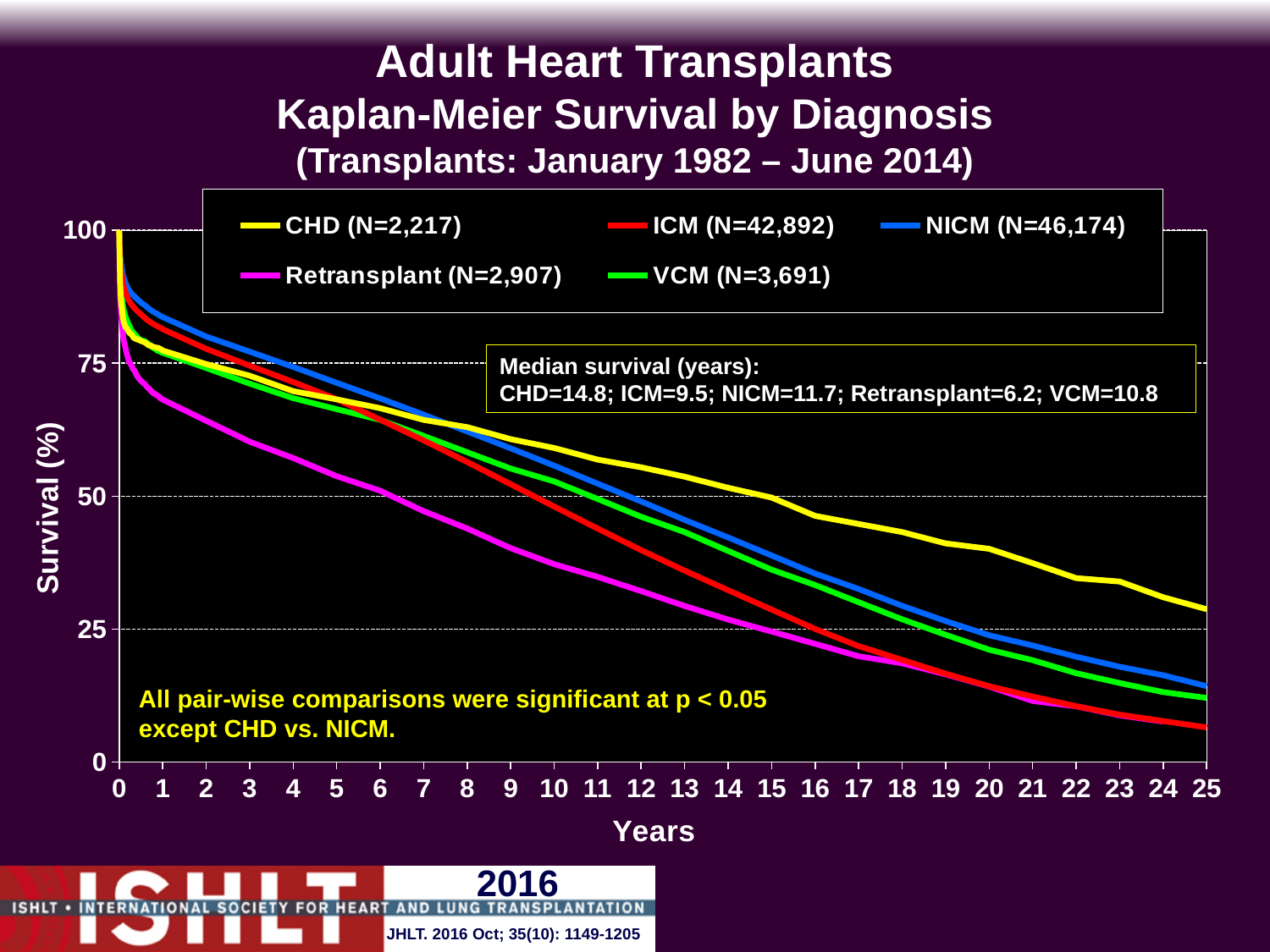
Which pair-wise comparison was not significant at p < 0.05? CHD vs. NICM What is the N for the ICM group shown in the legend? 42,892 What is the median survival in years for the CHD group? 14.8 How many diagnosis groups (series) does the legend list? 5 Which diagnosis group has the lowest median survival? Retransplant Do the survival curves rise or fall as years increase along the x axis? Fall Which group has the larger median survival, NICM or VCM? NICM How many years longer is the median survival for CHD than for ICM? 5.3 Is the survival value for the Retransplant curve at 10 years greater or less than 50? less Which diagnosis group has the highest median survival? CHD What kind of chart is shown on the slide? Line chart Is the survival value for the CHD curve at 25 years greater or less than 25? greater